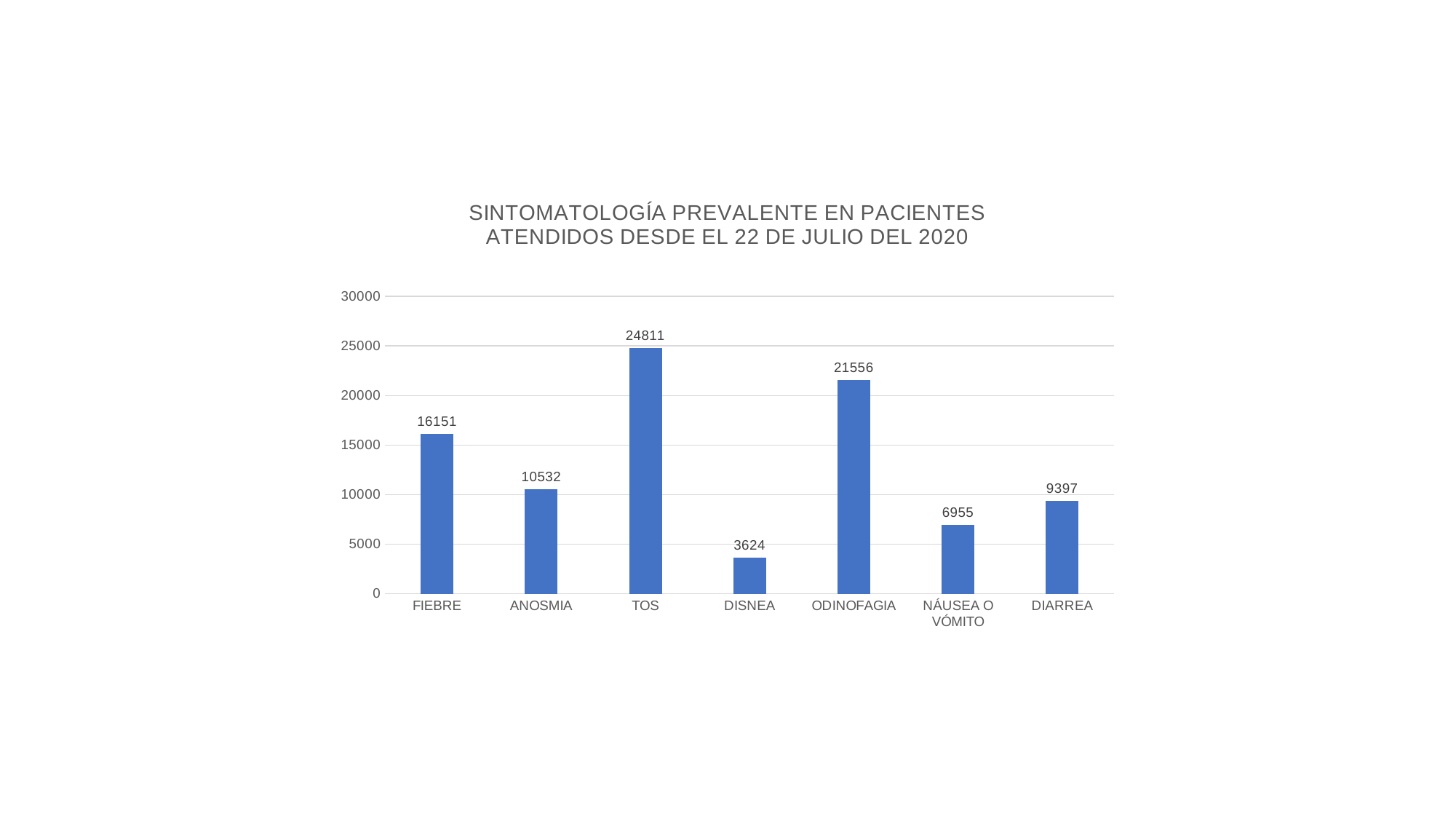
What is the value for TOS? 24811 How many symptom categories are shown on the chart? 7 What is the value for NÁUSEA O VÓMITO? 6955 What is the title of the chart? SINTOMATOLOGÍA PREVALENTE EN PACIENTES ATENDIDOS DESDE EL 22 DE JULIO DEL 2020 Is the value for ODINOFAGIA greater or less than 20000? greater Which is larger, the value for FIEBRE or the value for ANOSMIA? FIEBRE Which symptom has the highest value? TOS What kind of chart is shown on the slide? bar chart What is the value for FIEBRE? 16151 What is the difference between the values for ANOSMIA and DIARREA? 1135 What is the difference between the values for TOS and ODINOFAGIA? 3255 Which symptom has the lowest value? DISNEA